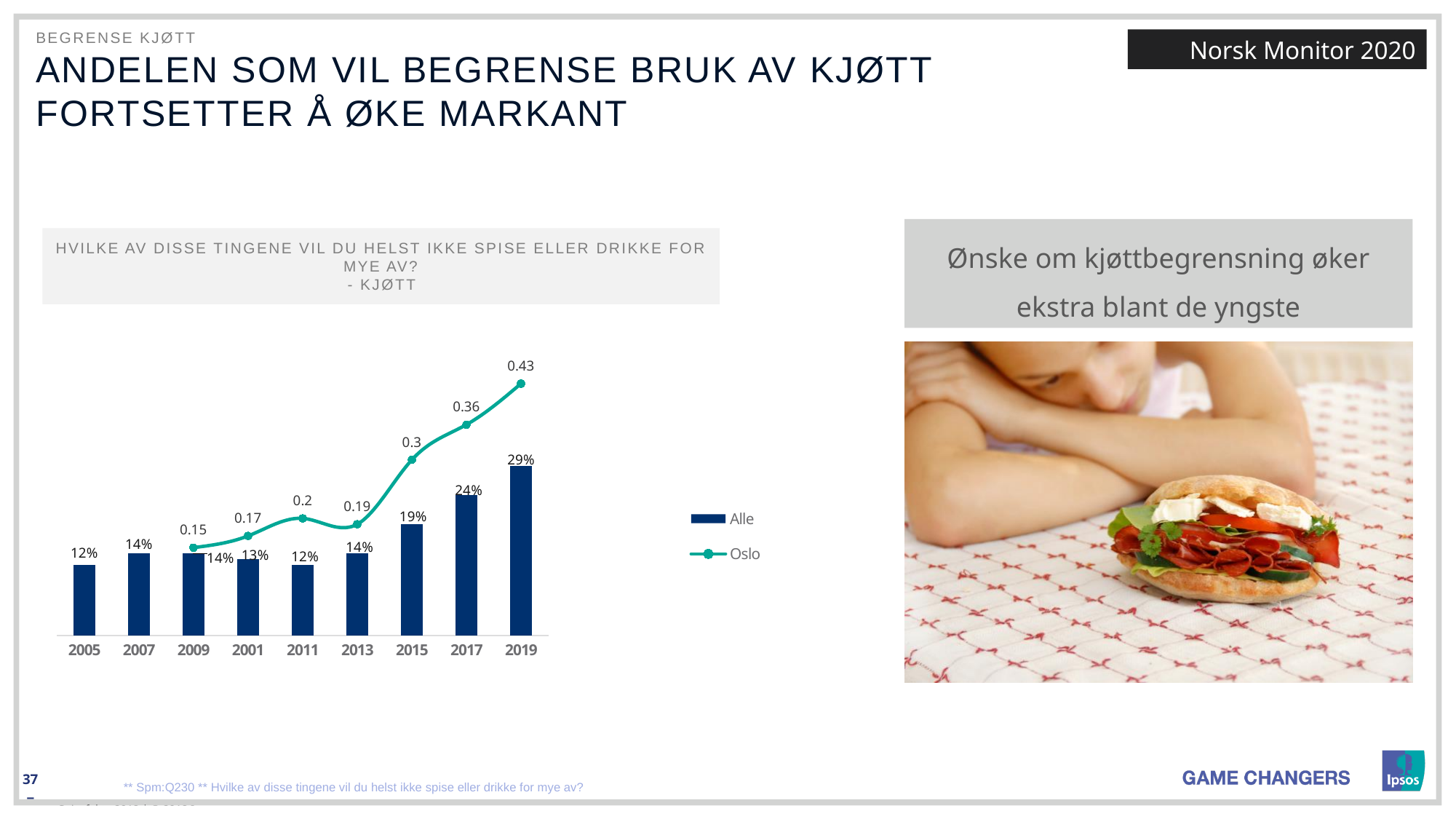
What is the difference between the Alle values for 2019 and 2017? 5 percentage points What is the value for Alle in 2015? 19% Does the Alle series rise or fall from 2013 to 2019? Rise In which year is the Alle series highest? 2019 What is the value for Oslo in 2013? 0.19 What is the value for Oslo in 2019? 0.43 What is the difference between the Oslo values for 2019 and 2017? 0.07 Which year has the larger Alle value, 2015 or 2017? 2017 In which year is the Oslo series lowest? 2009 What is the value for Alle in 2019? 29% How many series does the legend list? 2 How many years are shown on the x axis? 9